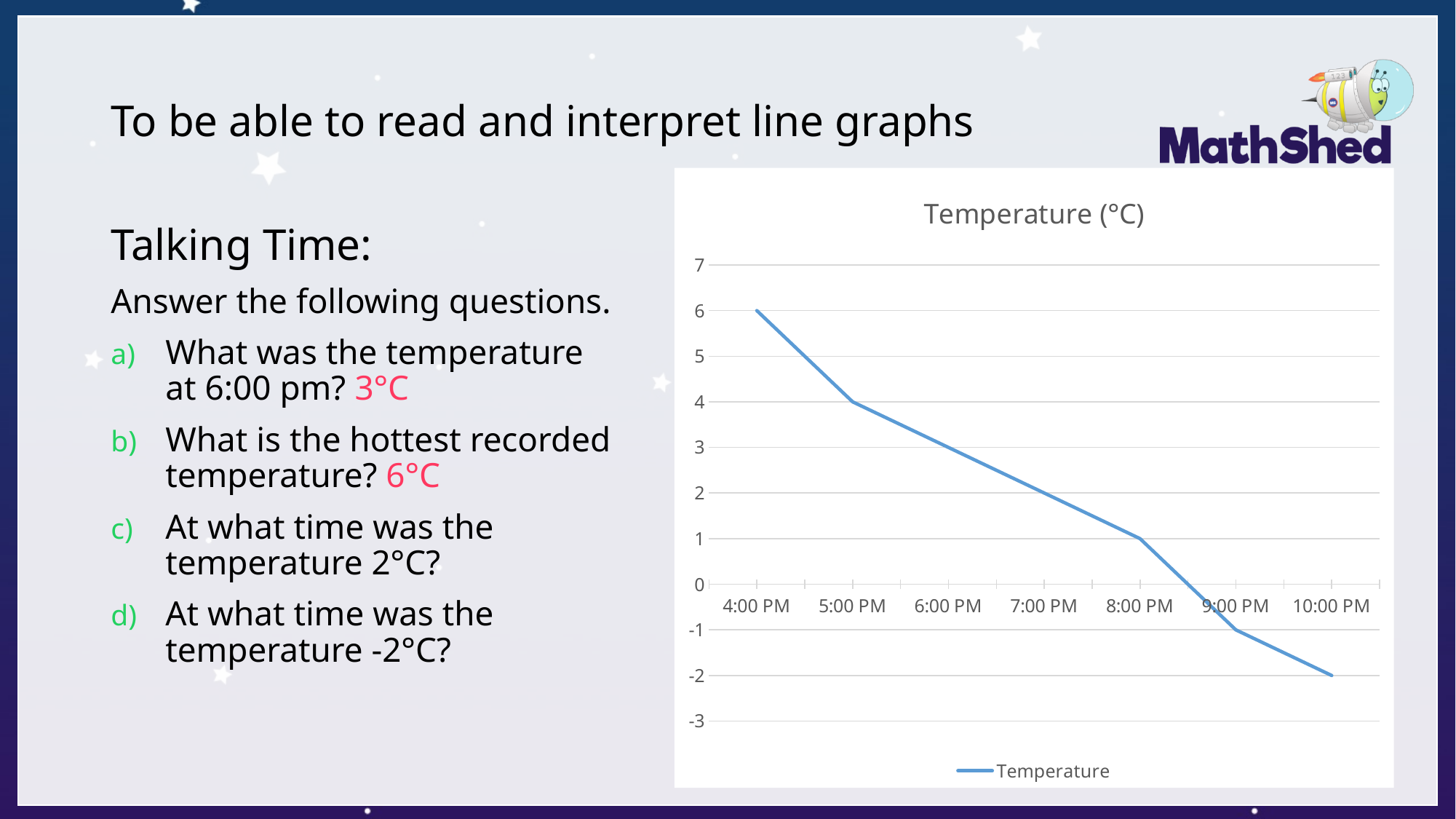
What is the difference between the temperature at 4:00 PM and at 5:00 PM? 2 What kind of chart is shown on the slide? line chart Is the temperature at 9:00 PM greater or less than 0? less What was the temperature at 10:00 PM? -2 At what time was the hottest temperature recorded? 4:00 PM Which is higher, the temperature at 5:00 PM or at 8:00 PM? 5:00 PM Does the temperature rise or fall from 4:00 PM to 10:00 PM? fall How many time points are plotted on the chart? 7 What was the temperature at 6:00 PM? 3°C What was the temperature at 4:00 PM? 6 At what time was the lowest temperature recorded? 10:00 PM How many series does the legend list? 1